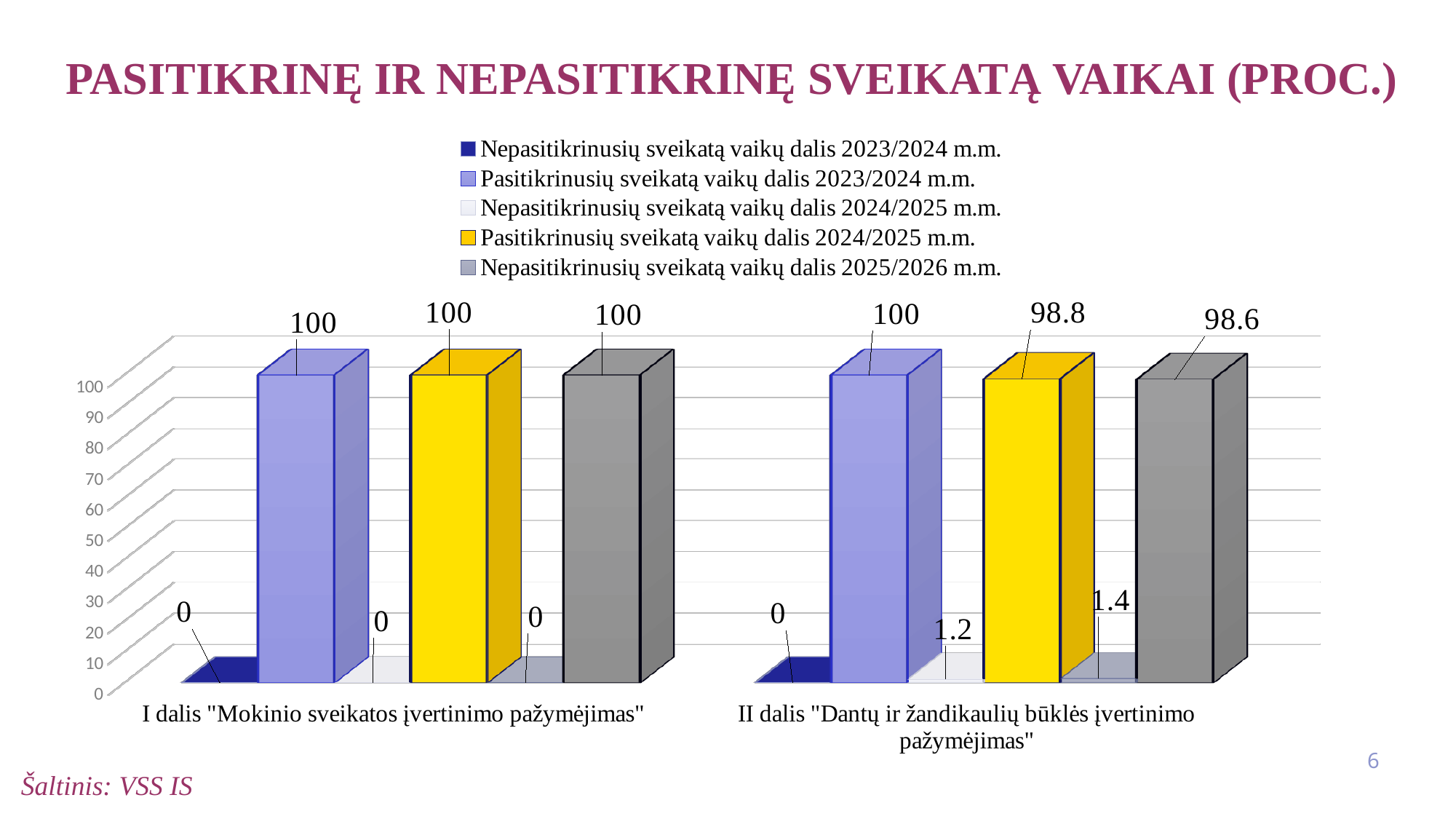
What is the value of "Nepasitikrinusių sveikatą vaikų dalis 2023/2024 m.m." for I dalis "Mokinio sveikatos įvertinimo pažymėjimas"? 0 What is the difference between the "Pasitikrinusių sveikatą vaikų dalis 2024/2025 m.m." values for I dalis and II dalis? 1.2 For II dalis "Dantų ir žandikaulių būklės įvertinimo pažymėjimas", which is larger: "Nepasitikrinusių sveikatą vaikų dalis 2024/2025 m.m." or "Nepasitikrinusių sveikatą vaikų dalis 2025/2026 m.m."? Nepasitikrinusių sveikatą vaikų dalis 2025/2026 m.m. What is the value of "Nepasitikrinusių sveikatą vaikų dalis 2024/2025 m.m." for II dalis "Dantų ir žandikaulių būklės įvertinimo pažymėjimas"? 1.2 How many categories are shown on the x axis of the chart? 2 How many series does the chart's legend list? 5 What kind of chart is shown on the slide? bar chart What is the value of "Pasitikrinusių sveikatą vaikų dalis 2023/2024 m.m." for I dalis "Mokinio sveikatos įvertinimo pažymėjimas"? 100 What is the value of "Pasitikrinusių sveikatą vaikų dalis 2024/2025 m.m." for II dalis "Dantų ir žandikaulių būklės įvertinimo pažymėjimas"? 98.8 What is the title of the chart on the slide? PASITIKRINĘ IR NEPASITIKRINĘ SVEIKATĄ VAIKAI (PROC.) What is the value of "Nepasitikrinusių sveikatą vaikų dalis 2025/2026 m.m." for II dalis "Dantų ir žandikaulių būklės įvertinimo pažymėjimas"? 1.4 What source is cited for the chart data on the slide? VSS IS